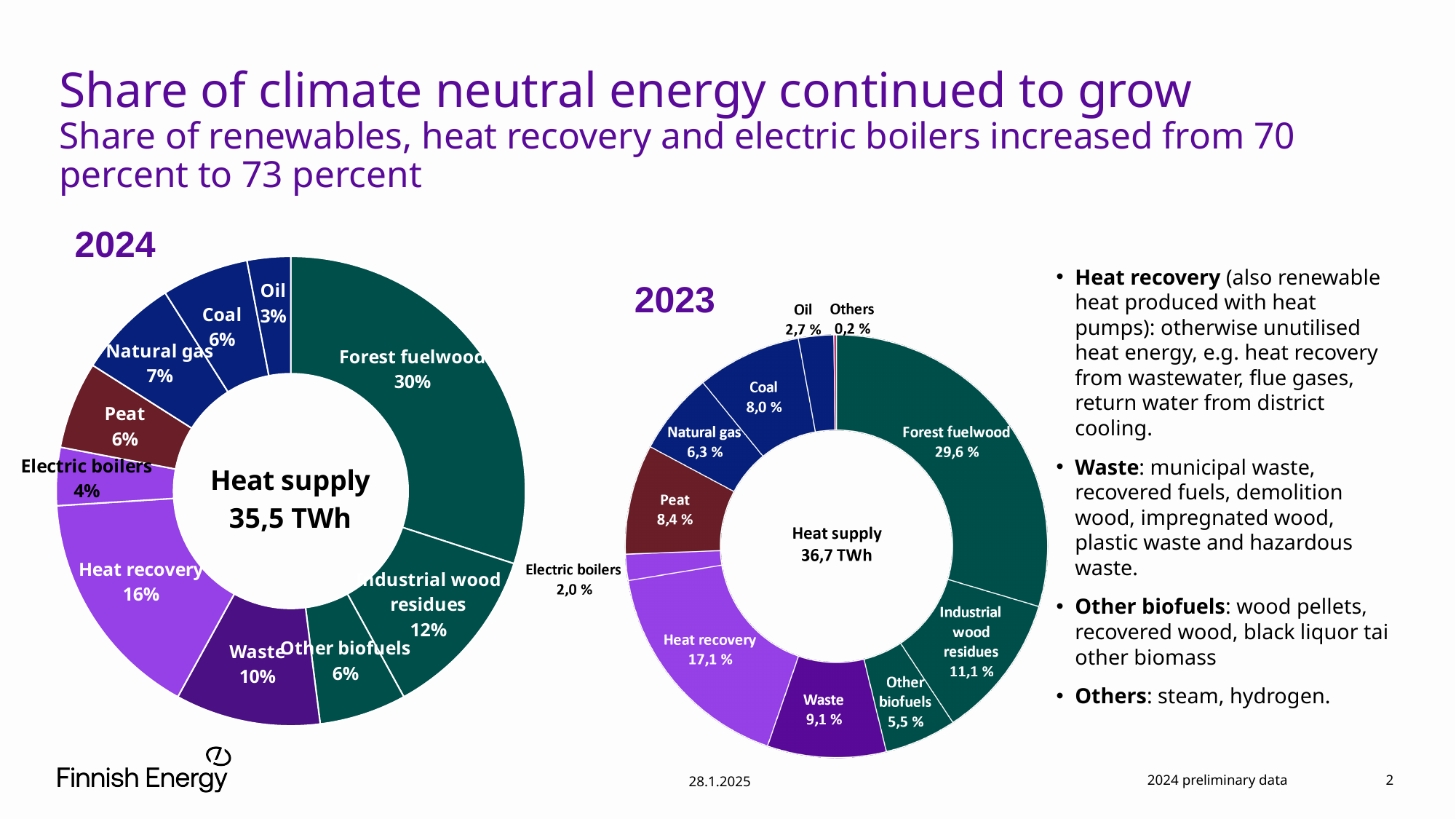
In the 2023 chart, what is the difference between the shares of Coal and Oil? 5,3 percentage points How many categories are shown in the 2024 chart? 10 What type of chart is used for the 2024 heat supply breakdown? Donut (pie) chart In the 2023 chart, which category has the smallest share? Others In the 2023 chart, what share does Heat recovery have? 17,1 % In the 2024 chart, what share does Forest fuelwood have? 30% In the 2023 chart, what is the total heat supply shown in the centre? 36,7 TWh In the 2024 chart, what is the difference between the shares of Heat recovery and Waste? 6 percentage points In the 2023 chart, which is larger, the share of Peat or the share of Natural gas? Peat In the 2024 chart, what is the total heat supply shown in the centre? 35,5 TWh In the 2024 chart, which category has the largest share? Forest fuelwood How many categories are shown in the 2023 chart? 11